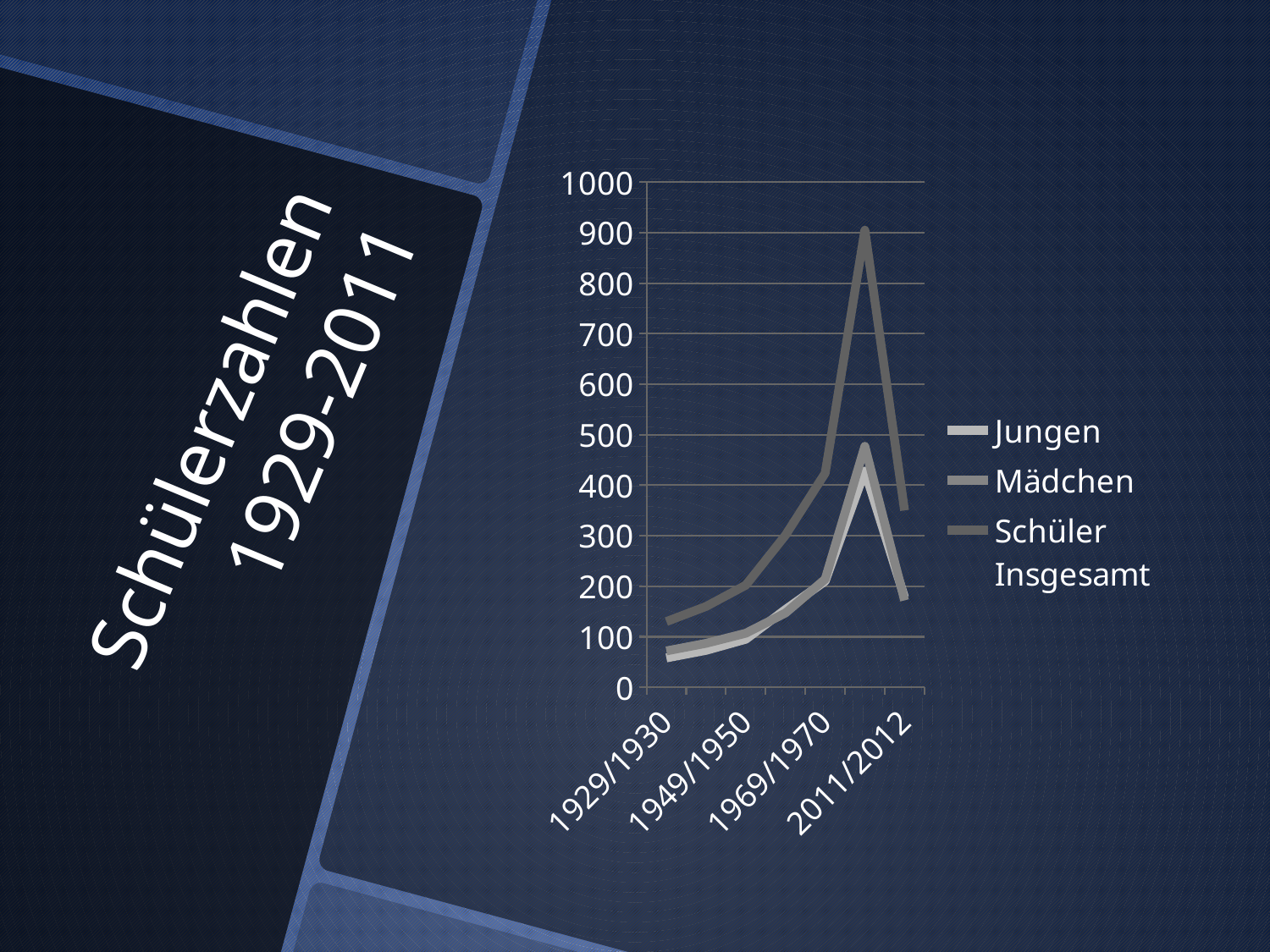
Is the value for Jungen in 1929/1930 greater or less than 100? less Is the value for Schüler Insgesamt in 2011/2012 greater or less than 400? less Is the value for Jungen in 2011/2012 greater or less than 200? less How many series does the legend list? 3 In 2011/2012, which is larger: the value for Schüler Insgesamt or the value for Jungen? Schüler Insgesamt Does the Schüler Insgesamt line rise or fall from 1929/1930 to 1969/1970? rise What kind of chart is shown on the slide? line chart What are the three series named in the legend? Jungen, Mädchen, Schüler Insgesamt Which series reaches the highest value on the chart? Schüler Insgesamt What is the title shown on the slide next to the chart? Schülerzahlen 1929-2011